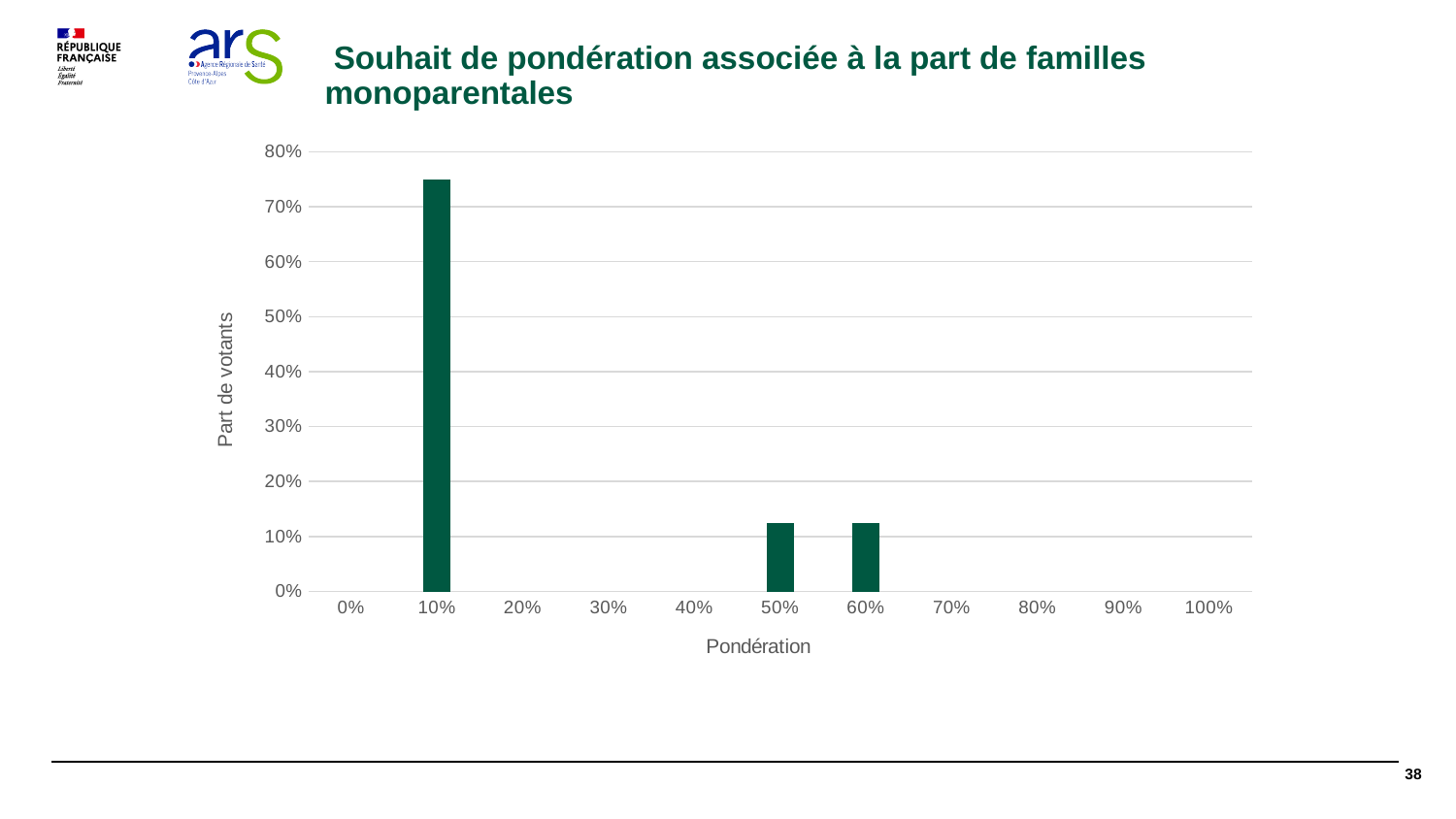
How many pondération categories have a visible bar (non-zero share of voters)? 3 Is the share of voters for the 50% pondération greater or less than 20%? less What is the label of the y axis? Part de votants Is the share of voters for the 60% pondération greater or less than 20%? less Which has a larger share of voters: the 10% pondération or the 50% pondération? 10% Is the share of voters for the 10% pondération greater or less than 80%? less What is the label of the x axis? Pondération Which has a larger share of voters: the 60% pondération or the 10% pondération? 10% What kind of chart is shown on the slide? bar chart Which pondération category has the highest share of voters (Part de votants)? 10% How many categories are shown along the x axis (Pondération)? 11